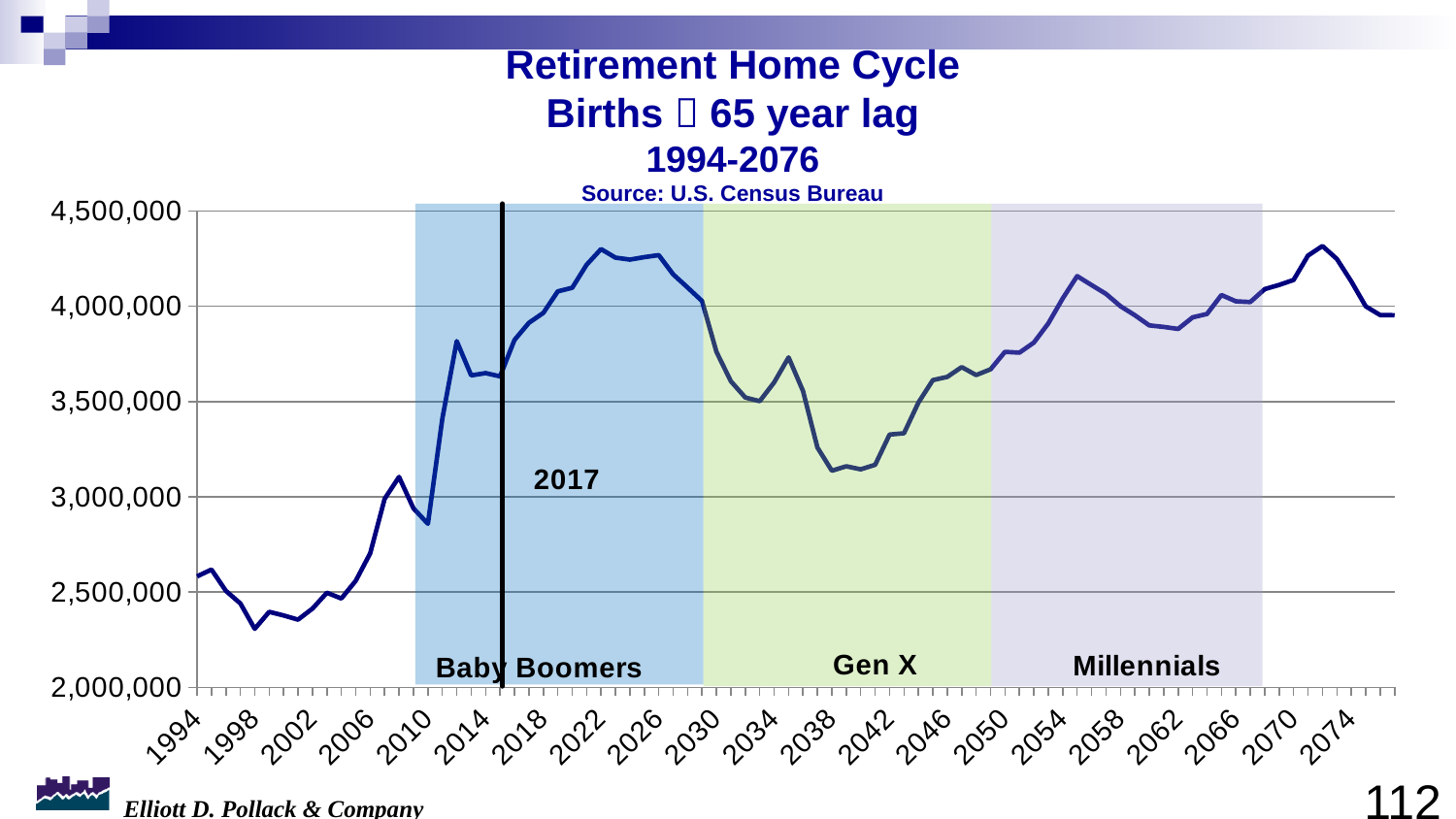
Is the value for 2000 greater or less than 2,500,000? less Is the value for 2010 greater or less than 3,000,000? less Which year has the larger value, 1994 or 2010? 2010 Is the value for 2038 greater or less than 3,500,000? less What year does the vertical black line on the chart mark? 2017 Do the values rise or fall between 2010 and 2022? rise Which year has the larger value, 2022 or 2038? 2022 Do the values rise or fall between 2030 and 2038? fall What kind of chart is shown on the slide? line chart